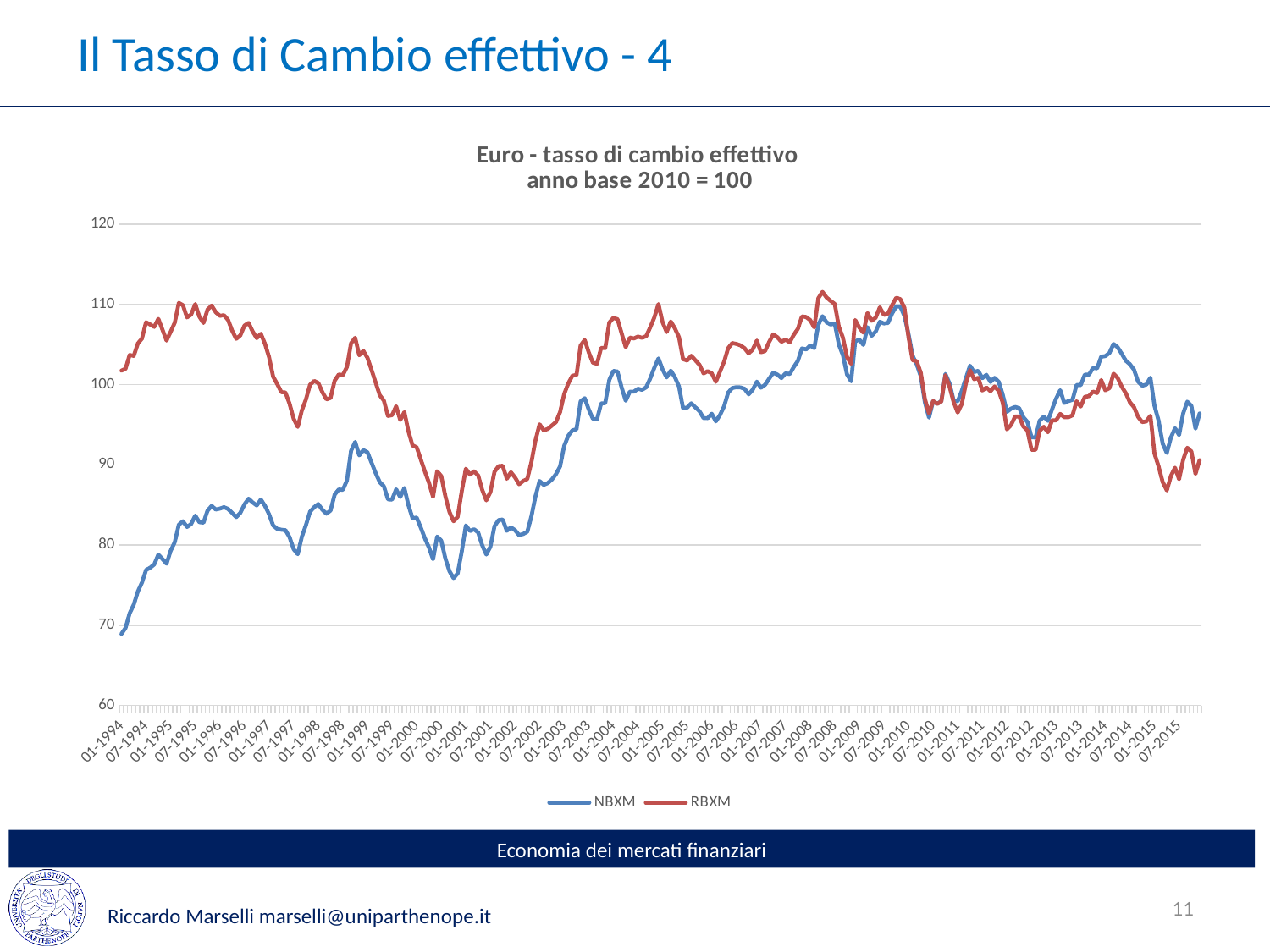
At 01-1994, which series has the higher value, NBXM or RBXM? RBXM At 01-2014, which series has the higher value, NBXM or RBXM? NBXM How many series does the legend list? 2 Is the value of NBXM at 01-2001 greater or less than 80? greater Is the value of NBXM at 07-2015 greater or less than 90? greater Is the value of RBXM at 01-1994 greater or less than 100? greater What is the title of the chart? Euro - tasso di cambio effettivo anno base 2010 = 100 What kind of chart is shown on the slide? line chart Does the NBXM series rise or fall between 01-1994 and 01-1999? rise Which colour is used for the NBXM series? blue Does the RBXM series rise or fall between 01-1999 and 01-2001? fall